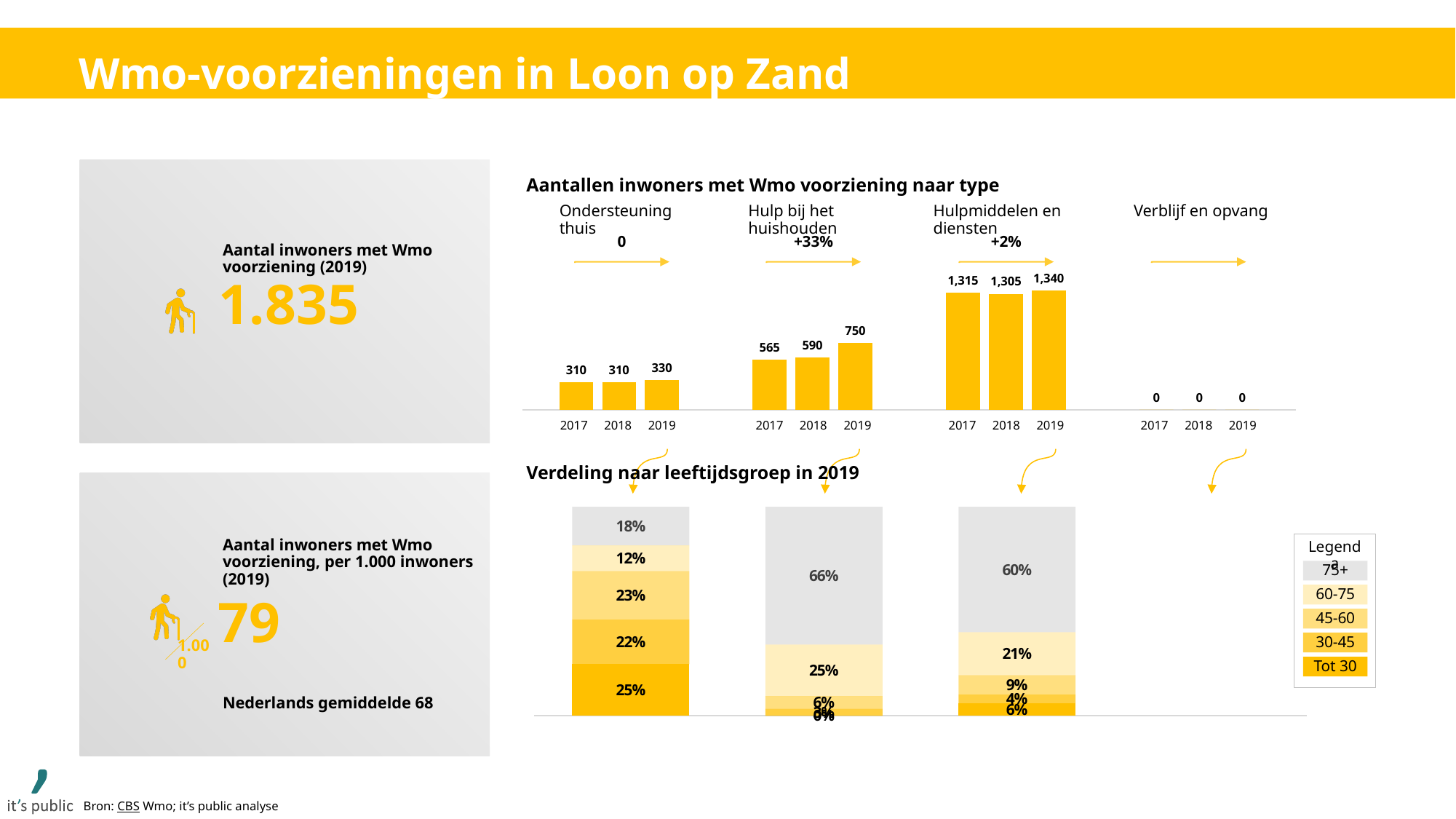
In the chart 'Aantallen inwoners met Wmo voorziening naar type', which is larger: Ondersteuning thuis in 2019 or Hulp bij het huishouden in 2017? Hulp bij het huishouden in 2017 What kind of chart is 'Aantallen inwoners met Wmo voorziening naar type'? bar chart In the chart 'Aantallen inwoners met Wmo voorziening naar type', what is the value for Hulp bij het huishouden in 2019? 750 In the chart 'Aantallen inwoners met Wmo voorziening naar type', what is the value for Hulpmiddelen en diensten in 2017? 1,315 In the chart 'Aantallen inwoners met Wmo voorziening naar type', which year has the highest value for Hulpmiddelen en diensten? 2019 In the chart 'Aantallen inwoners met Wmo voorziening naar type', what percentage change is shown above the Hulp bij het huishouden bars? +33% In the chart 'Verdeling naar leeftijdsgroep in 2019', what share of Hulpmiddelen en diensten is the 75+ age group? 60% In the chart 'Verdeling naar leeftijdsgroep in 2019', what share of Ondersteuning thuis is the Tot 30 age group? 25% How many age groups does the legend of the chart 'Verdeling naar leeftijdsgroep in 2019' list? 5 In the chart 'Aantallen inwoners met Wmo voorziening naar type', do the values for Hulp bij het huishouden rise or fall from 2017 to 2019? rise In the chart 'Aantallen inwoners met Wmo voorziening naar type', what is the value for Verblijf en opvang in 2018? 0 In the chart 'Aantallen inwoners met Wmo voorziening naar type', what is the difference between the 2019 and 2017 values for Hulp bij het huishouden? 185